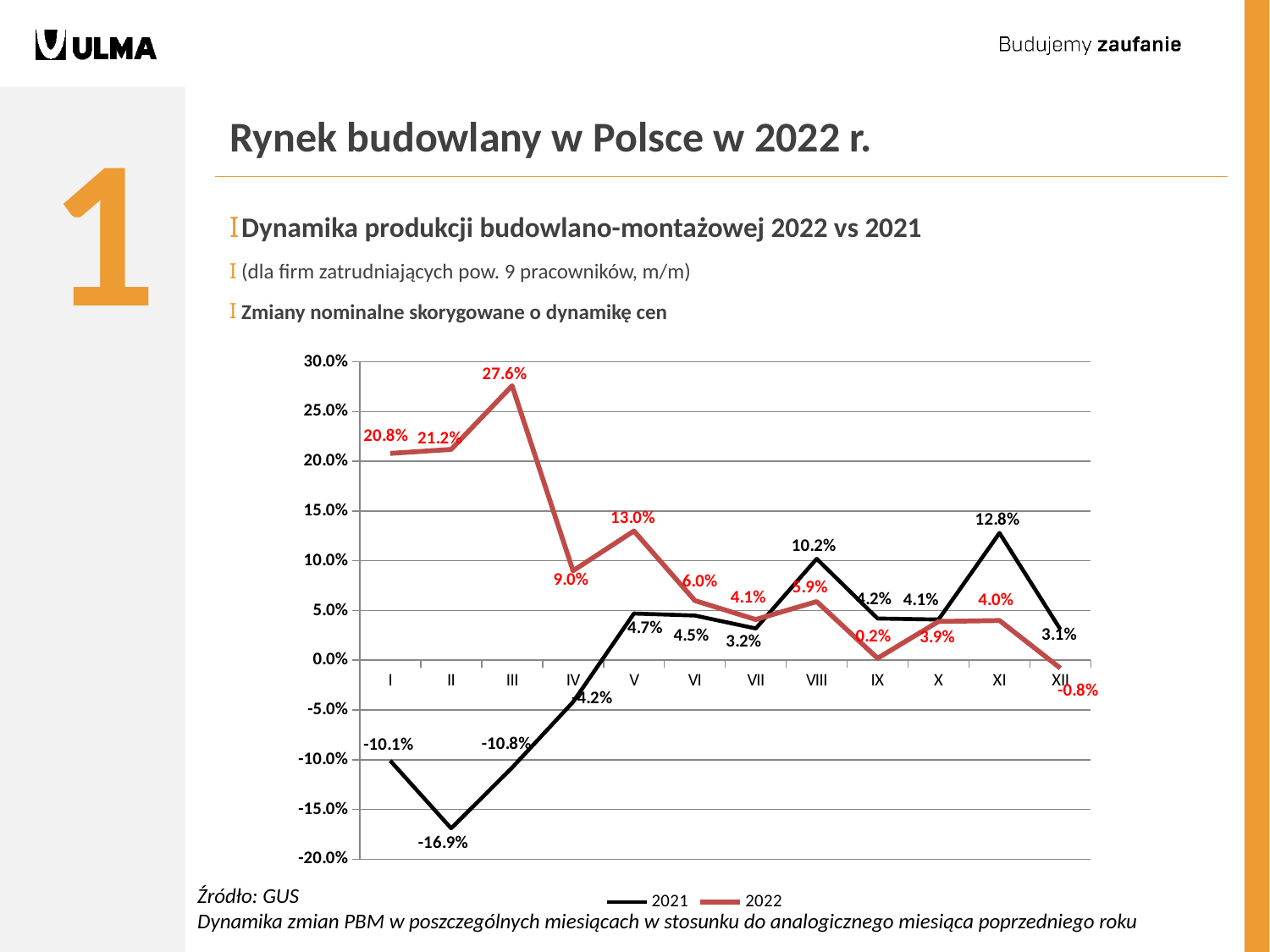
In which month does the 2021 series reach its lowest value? II What is the value for 2022 in month XII? -0.8% In which month does the 2022 series reach its highest value? III How many months are plotted on the x axis? 12 Does the 2022 series rise or fall from month III to month IV? Fall What is the value for 2021 in month II? -16.9% What is the difference between the 2022 and 2021 values in month I? 30.9 percentage points Which series has the larger value in month VIII, 2021 or 2022? 2021 What is the value for 2022 in month III? 27.6% What kind of chart is shown on the slide? Line chart What is the value for 2021 in month XI? 12.8% How many series does the legend list? 2